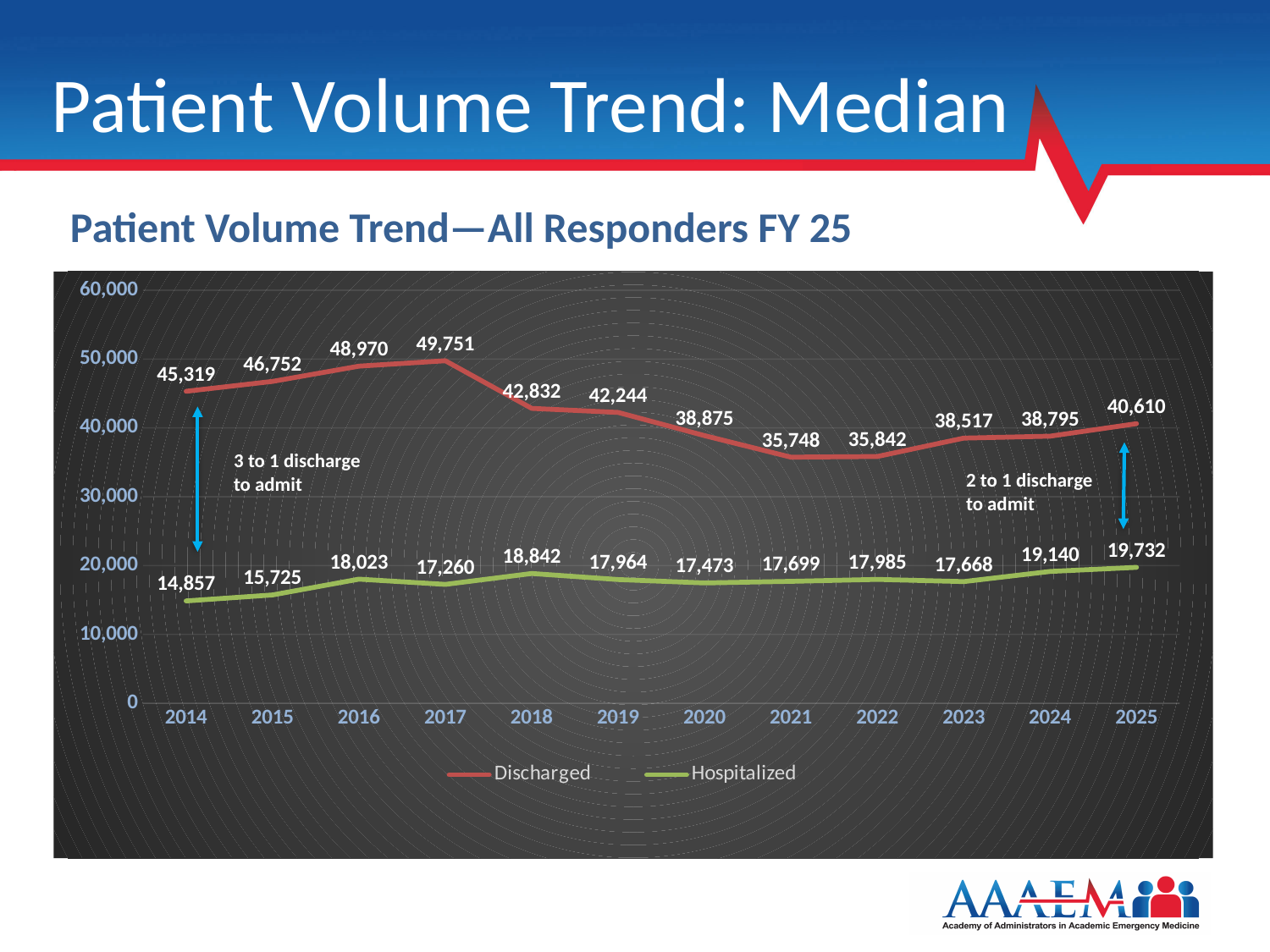
Is the Discharged value for 2021 greater or less than 40,000? less In which year is the Hospitalized value highest? 2025 How many years are shown on the x axis? 12 What is the Discharged value for 2025? 40,610 How many series does the legend list? 2 Which is larger, the Discharged value in 2016 or the Discharged value in 2018? 2016 In which year is the Discharged value lowest? 2021 What kind of chart is shown on the slide? line chart What is the Hospitalized value for 2014? 14,857 In which year is the Discharged value highest? 2017 What is the Discharged value for 2017? 49,751 What is the difference between the Discharged and Hospitalized values in 2025? 20,878